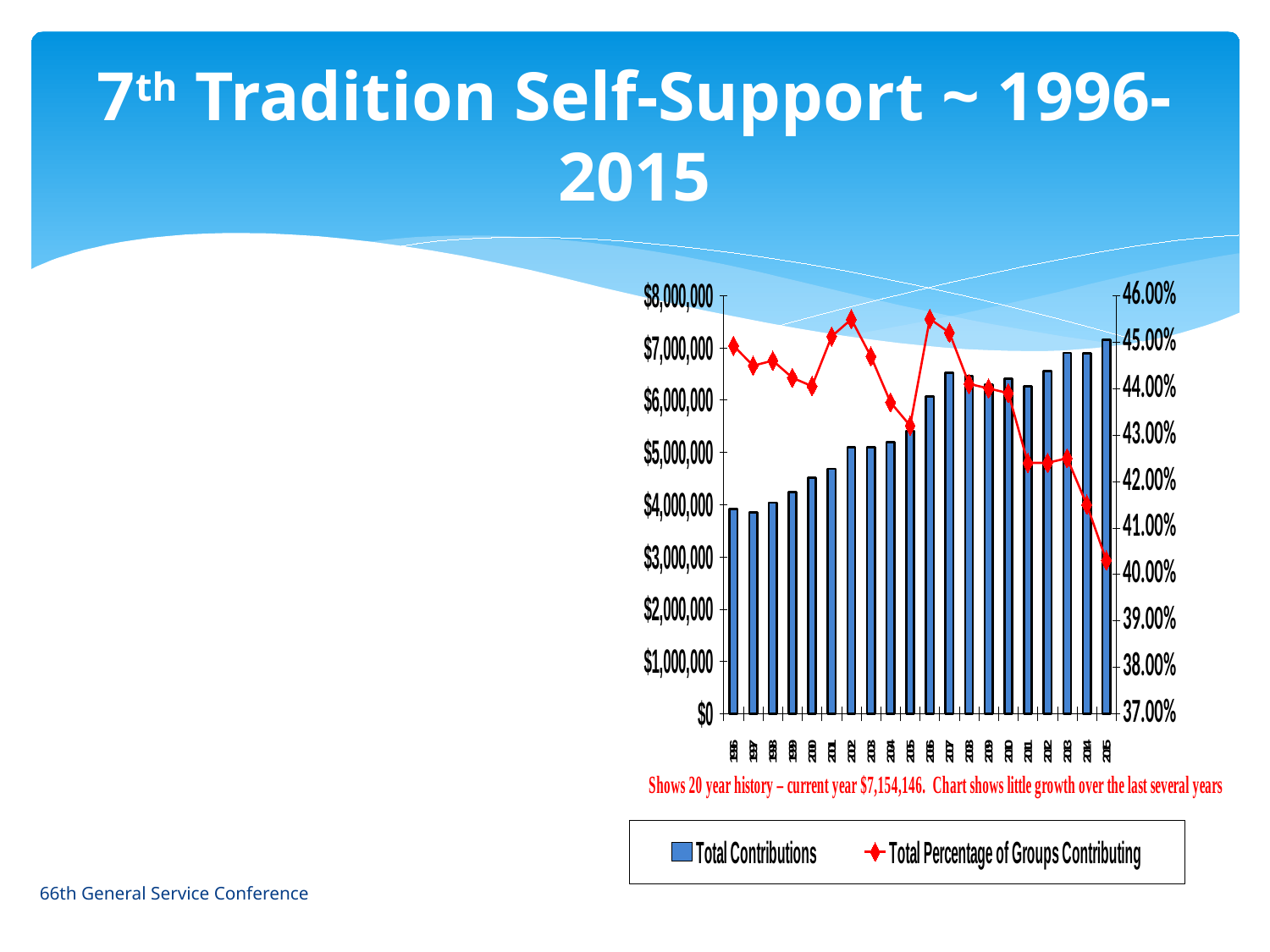
According to the caption below the chart, what is the current year's total contributions? $7,154,146 Is the Total Percentage of Groups Contributing for 2015 greater or less than 41.00%? less Is the Total Contributions value for 2015 greater or less than $7,000,000? greater Is the Total Contributions value for 2000 greater or less than $5,000,000? less What are the two entries in the chart's legend? Total Contributions; Total Percentage of Groups Contributing What kind of chart is shown on the slide? Combined bar and line chart How many data series does the chart's legend list? 2 Which year has the lowest Total Percentage of Groups Contributing? 2015 Do Total Contributions generally rise or fall from 1996 to 2015? rise Which is larger, the Total Percentage of Groups Contributing in 1996 or in 2015? 1996 How many years (bars) are plotted in the chart? 20 Which year has the highest Total Contributions bar? 2015